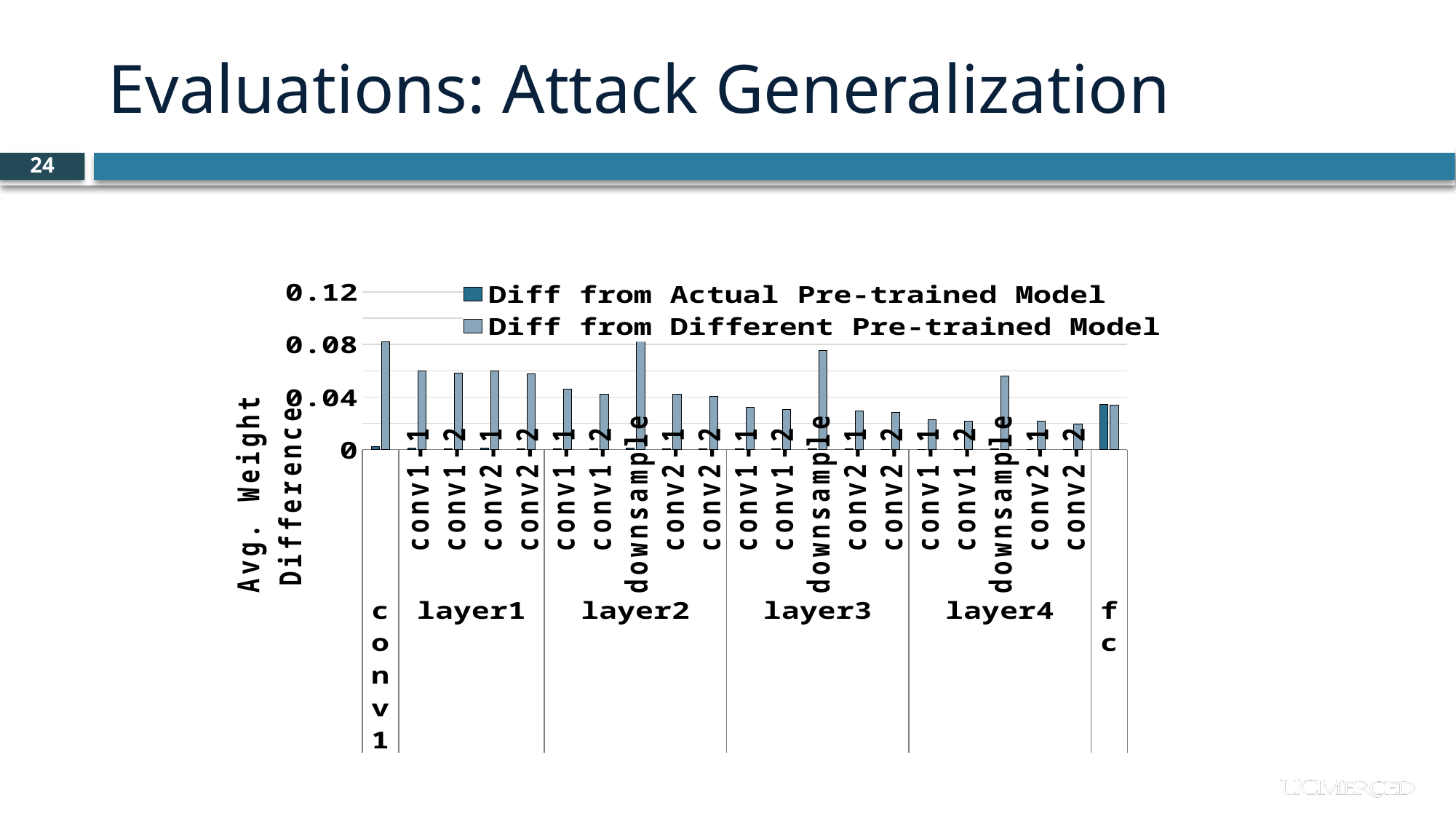
How many categories (bars groups) are plotted along the x axis? 21 Is the 'Diff from Different Pre-trained Model' value for layer1 conv1-1 greater or less than 0.04? greater Which is larger for 'Diff from Different Pre-trained Model': layer2 downsample or layer2 conv2-1? layer2 downsample Is the 'Diff from Different Pre-trained Model' value for layer2 downsample greater or less than 0.04? greater What is the y-axis title of the chart? Avg. Weight Difference What type of chart is shown on the slide? bar chart For which category is the 'Diff from Actual Pre-trained Model' bar the highest? fc Is the 'Diff from Different Pre-trained Model' value for layer3 downsample greater or less than 0.04? greater What are the two series named in the legend? Diff from Actual Pre-trained Model; Diff from Different Pre-trained Model Which is larger for 'Diff from Different Pre-trained Model': layer1 conv1-1 or layer4 conv1-1? layer1 conv1-1 How many series does the legend list? 2